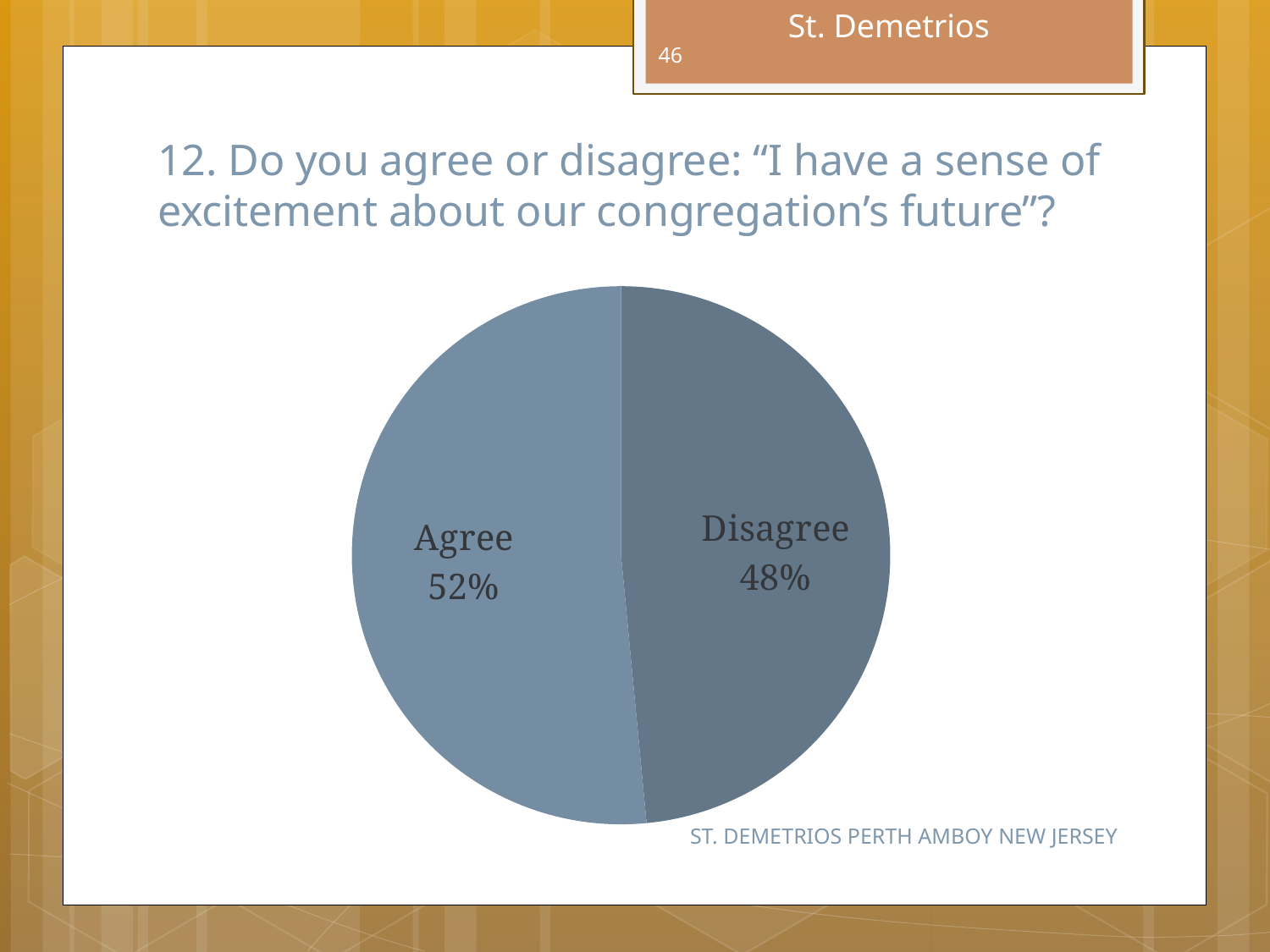
What percentage of respondents chose Agree? 52% What survey question does the chart on the slide present? 12. Do you agree or disagree: "I have a sense of excitement about our congregation's future"? Which response has the larger share of the pie? Agree What percentage of respondents chose Disagree? 48% Which is larger, the Agree slice or the Disagree slice? Agree What kind of chart is shown on the slide? pie chart What is the difference in percentage points between Agree and Disagree? 4 What is the total of the two slices shown in the pie chart? 100% Is the value for Agree greater or less than 50%? greater How many slices does the pie chart have? 2 What share of the pie does the Disagree slice represent? 48% Which response has the smaller share of the pie? Disagree